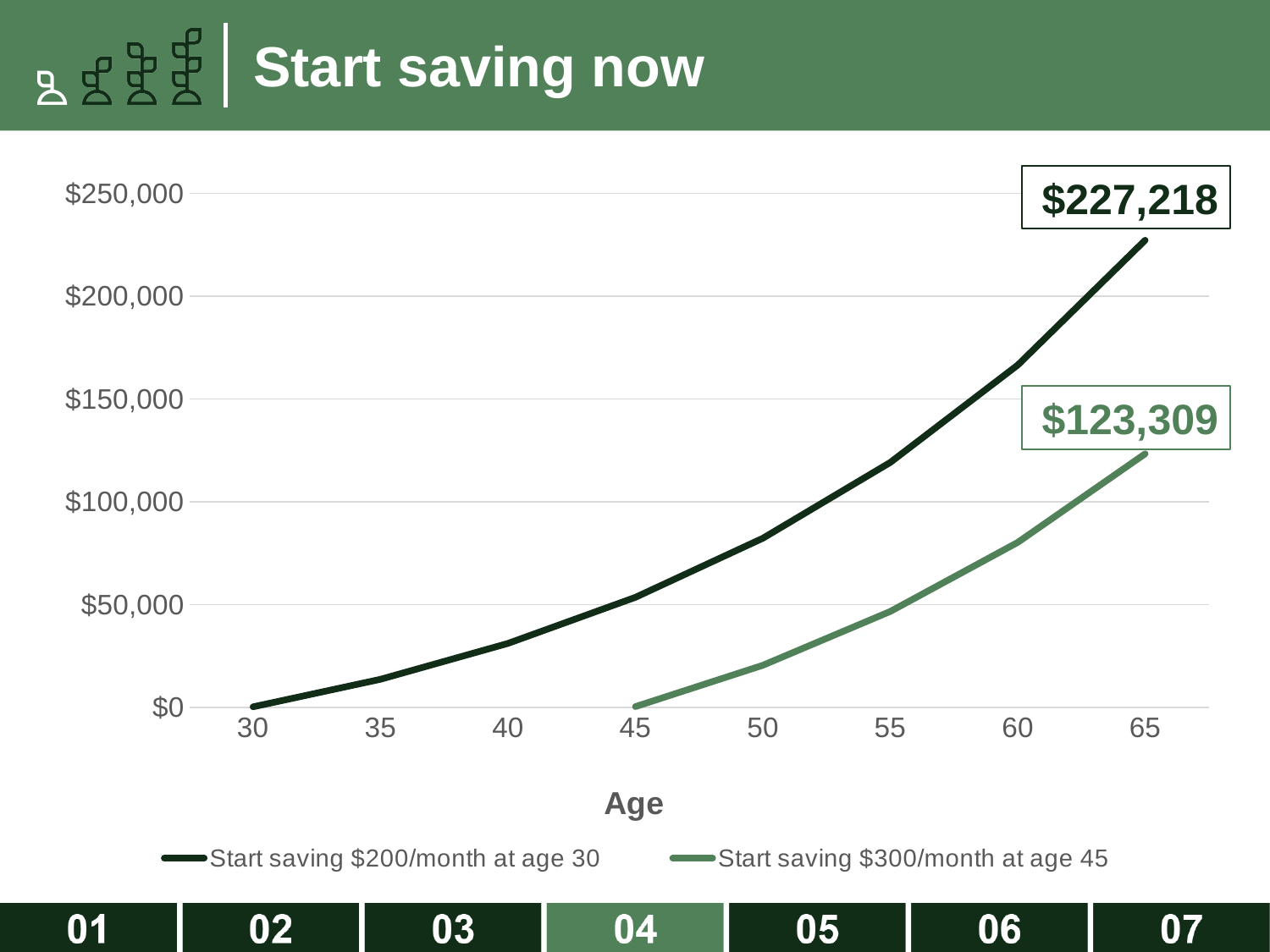
Is the value for 'Start saving $300/month at age 45' at age 60 greater or less than $100,000? less What is the labelled value of the 'Start saving $300/month at age 45' line at age 65? $123,309 Is the value for 'Start saving $200/month at age 30' at age 50 greater or less than $100,000? less What is the difference between the two labelled values at age 65? $103,909 What is the title of the x axis? Age Which series has the larger value at age 65? Start saving $200/month at age 30 How many age ticks are shown on the x axis? 8 How many series does the legend list? 2 Do the values of the 'Start saving $200/month at age 30' line rise or fall as age increases? rise Is the value for 'Start saving $200/month at age 30' at age 60 greater or less than $150,000? greater What kind of chart is shown on the slide? line chart What is the labelled value of the 'Start saving $200/month at age 30' line at age 65? $227,218